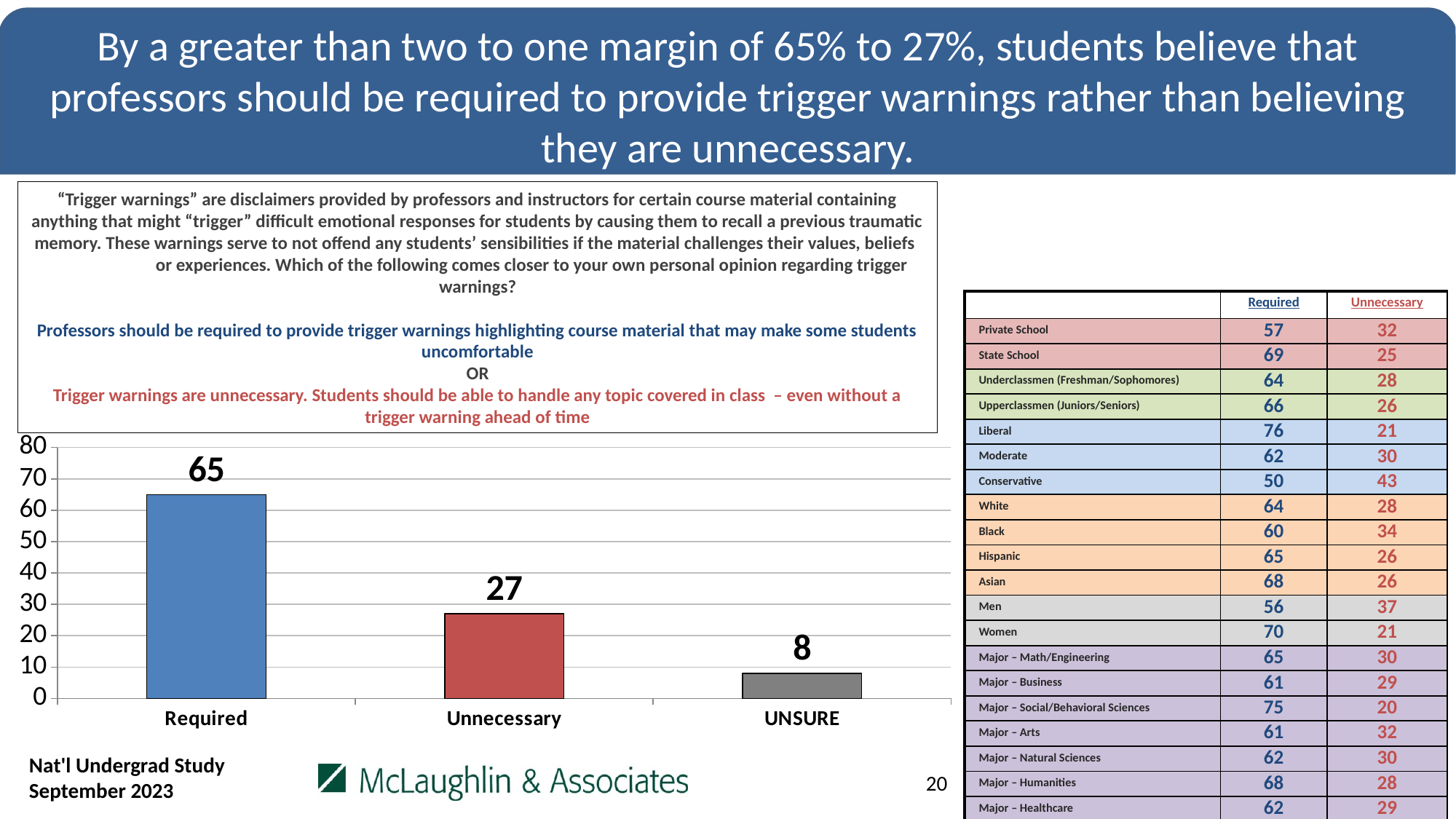
Which is larger in the bar chart, Unnecessary or UNSURE? Unnecessary Which category has the highest value in the bar chart? Required What is the difference between the Required and Unnecessary values in the bar chart? 38 What is the value for Required in the bar chart? 65 Is the value for Required in the bar chart greater or less than 60? greater Which category has the lowest value in the bar chart? UNSURE Do the values rise or fall from left to right across the bar chart? fall What is the value for Unnecessary in the bar chart? 27 What is the value for UNSURE in the bar chart? 8 What kind of chart is shown on the slide? bar chart What colour is the Unnecessary bar in the bar chart? red How many categories are shown in the bar chart? 3